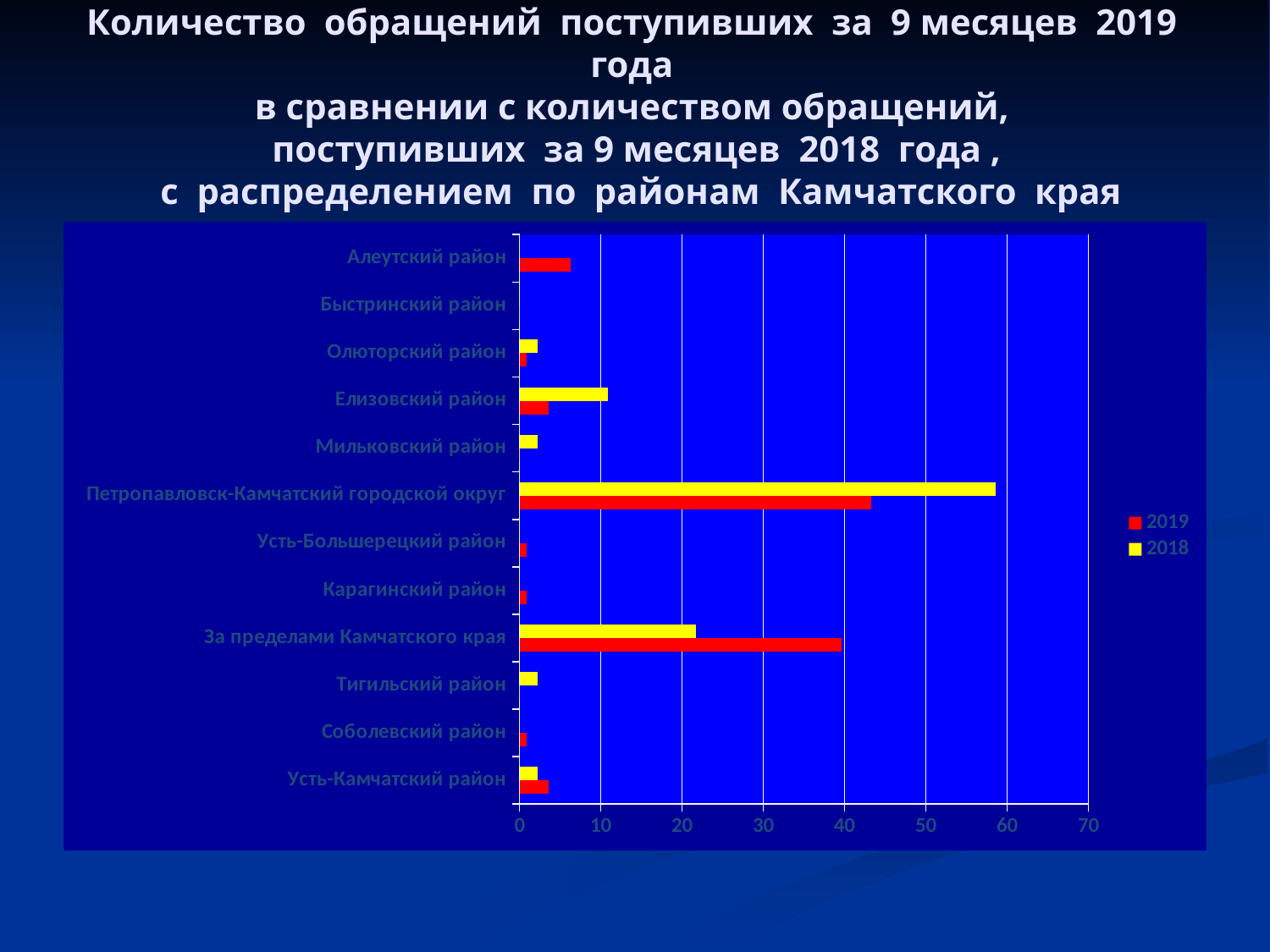
Is the 2018 value for Петропавловск-Камчатский городской округ greater or less than 50? greater For За пределами Камчатского края, which series has the larger value, 2019 or 2018? 2019 What kind of chart is shown on the slide? bar chart Is the 2019 value for Петропавловск-Камчатский городской округ greater or less than 50? less Which category has the highest value for the 2018 series? Петропавловск-Камчатский городской округ For Петропавловск-Камчатский городской округ, which series has the larger value, 2019 or 2018? 2018 Which colour represents the 2019 series in the legend? red How many districts (categories) are listed on the vertical axis? 12 Is the 2019 value for За пределами Камчатского края greater or less than 30? greater Which category has the highest value for the 2019 series? Петропавловск-Камчатский городской округ How many series does the legend list? 2